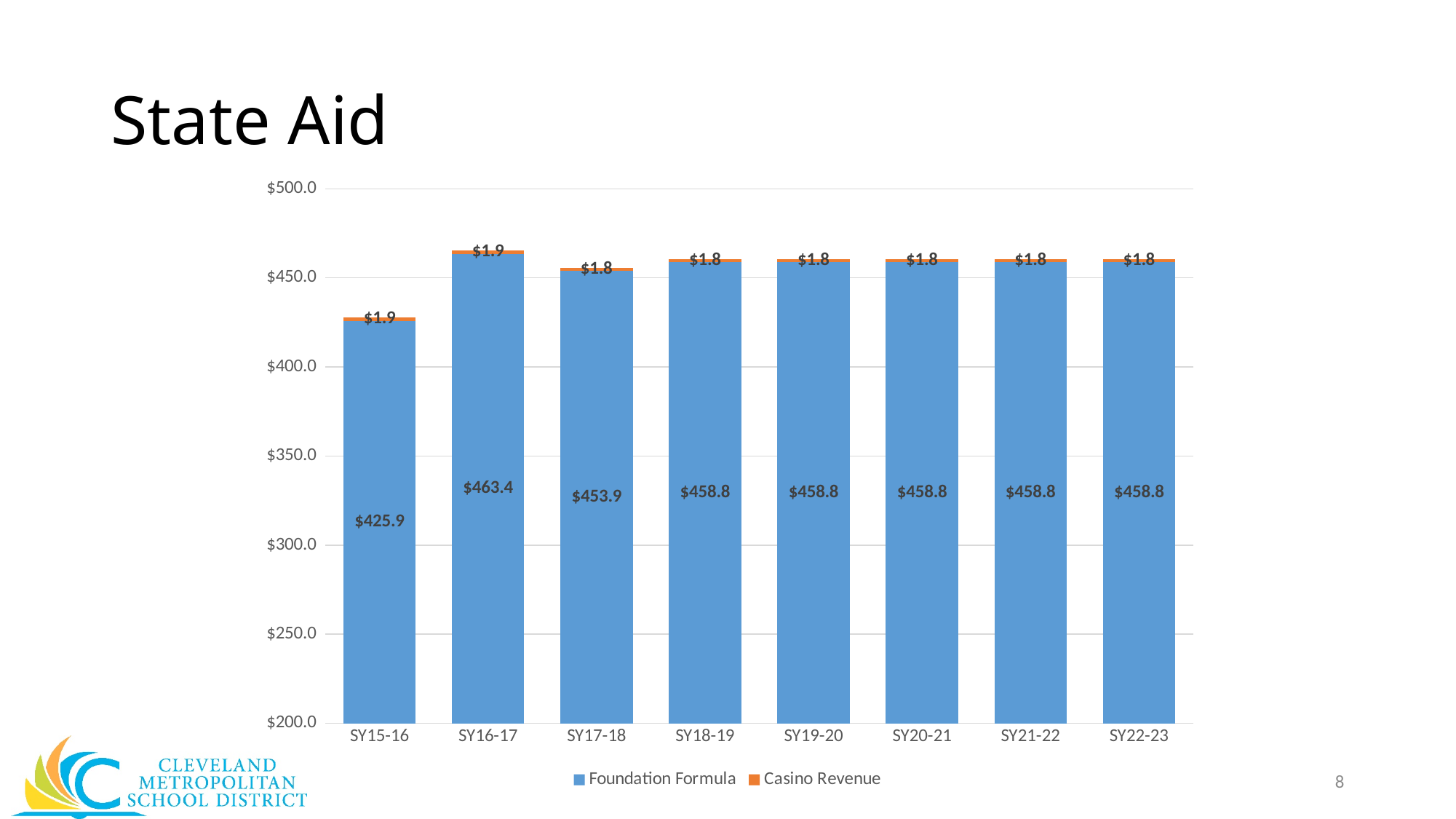
What is the Foundation Formula value for SY17-18? $453.9 What is the Casino Revenue value for SY16-17? $1.9 What kind of chart is shown on the slide? Stacked bar chart Which school year has the highest Foundation Formula value? SY16-17 What is the Foundation Formula value for SY15-16? $425.9 What is the total of the stacked bar for SY16-17? $465.3 Is the Foundation Formula value for SY15-16 greater or less than $450.0? less How many series does the legend list? 2 How many school years are shown on the x axis? 8 What is the difference between the Foundation Formula values for SY16-17 and SY15-16? $37.5 Is the Foundation Formula value for SY16-17 larger than the value for SY17-18? Yes Which school year has the lowest Foundation Formula value? SY15-16